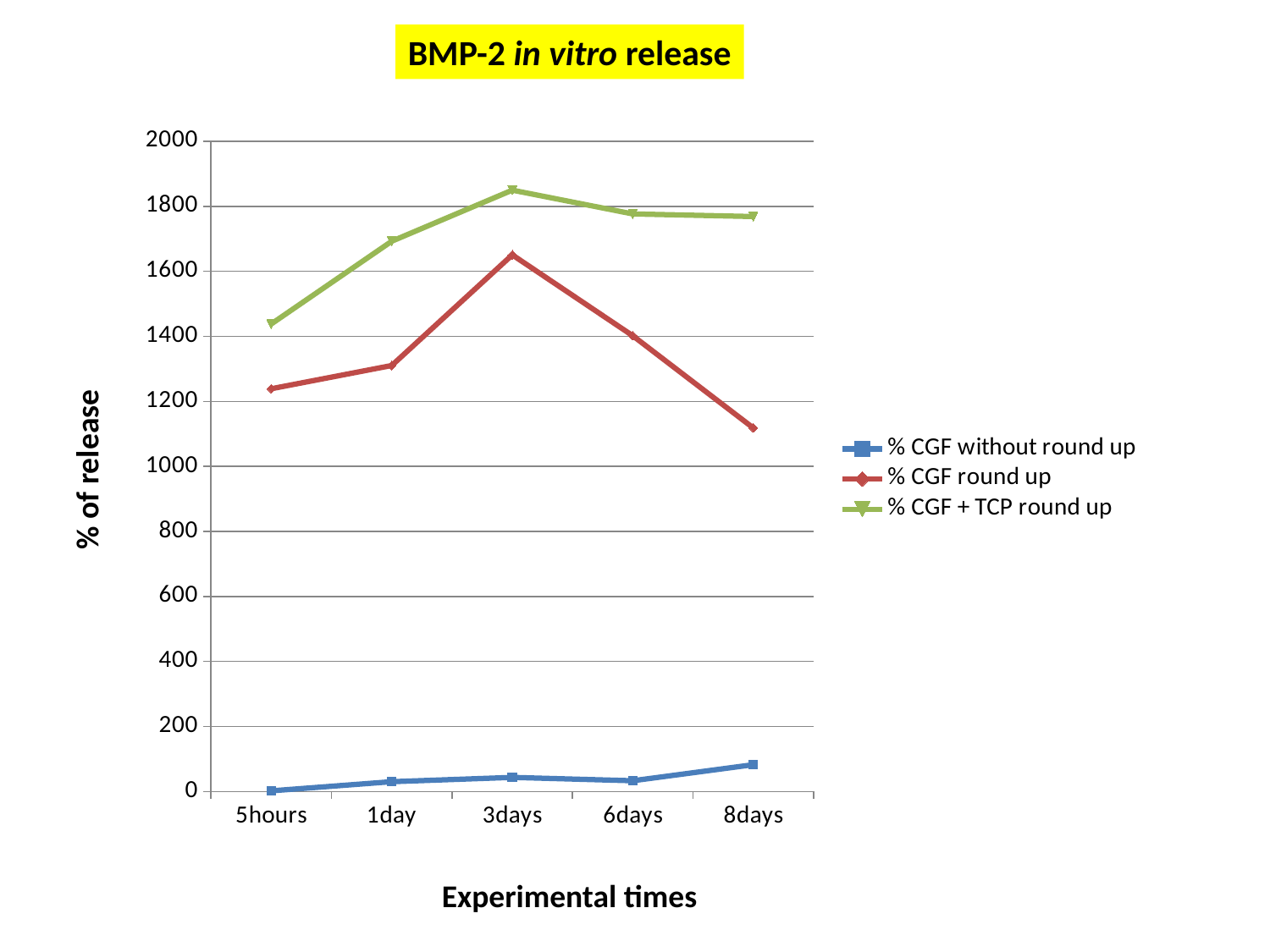
At which experimental time does the % CGF round up series reach its highest value? 3days What kind of chart is shown on the slide? line chart At which experimental time is the % CGF round up series at its lowest? 8days Is the value for % CGF without round up at 8days greater or less than 200? less Does the % CGF round up series rise or fall from 3days to 8days? fall At 6days, which is larger: % CGF round up or % CGF + TCP round up? % CGF + TCP round up How many series does the legend list? 3 What is the title of the y axis? % of release How many experimental time points are plotted along the x axis? 5 At which experimental time does the % CGF + TCP round up series reach its highest value? 3days Is the value for % CGF + TCP round up at 5hours greater or less than 1600? less Is the value for % CGF round up at 8days greater or less than 1200? less